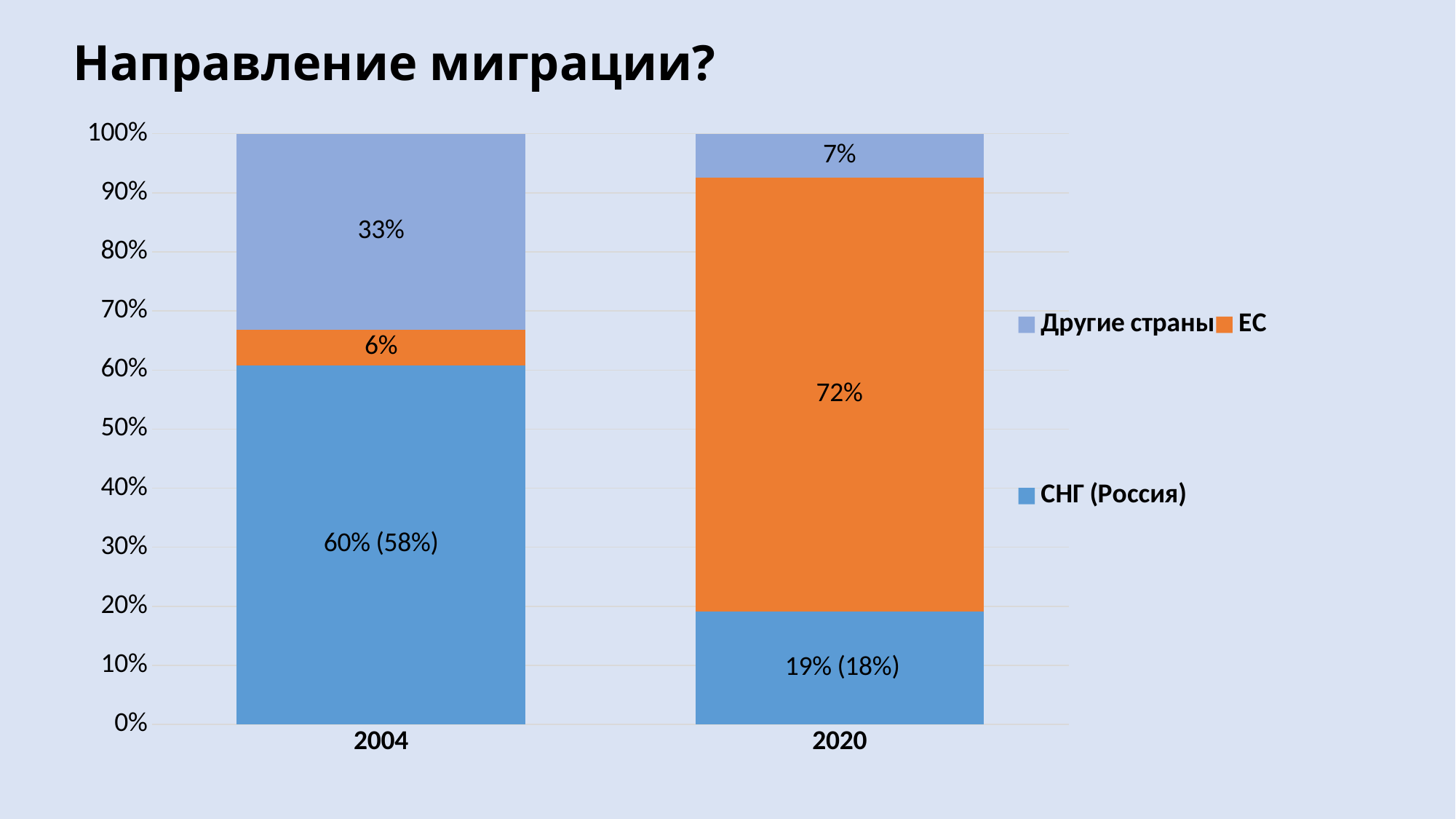
What is the value for Другие страны in 2020? 7% What is the data label for СНГ (Россия) in 2004? 60% (58%) Which series has the largest share in 2020? ЕС What is the value for ЕС in 2020? 72% What kind of chart is shown on the slide? Stacked bar chart What is the value for Другие страны in 2004? 33% What is the title of the slide? Направление миграции? What is the value for ЕС in 2004? 6% How many series does the legend list? 3 Which series has the smallest share in 2004? ЕС Which is larger: Другие страны in 2004 or Другие страны in 2020? Другие страны in 2004 What is the difference between the ЕС value in 2020 and the ЕС value in 2004? 66%